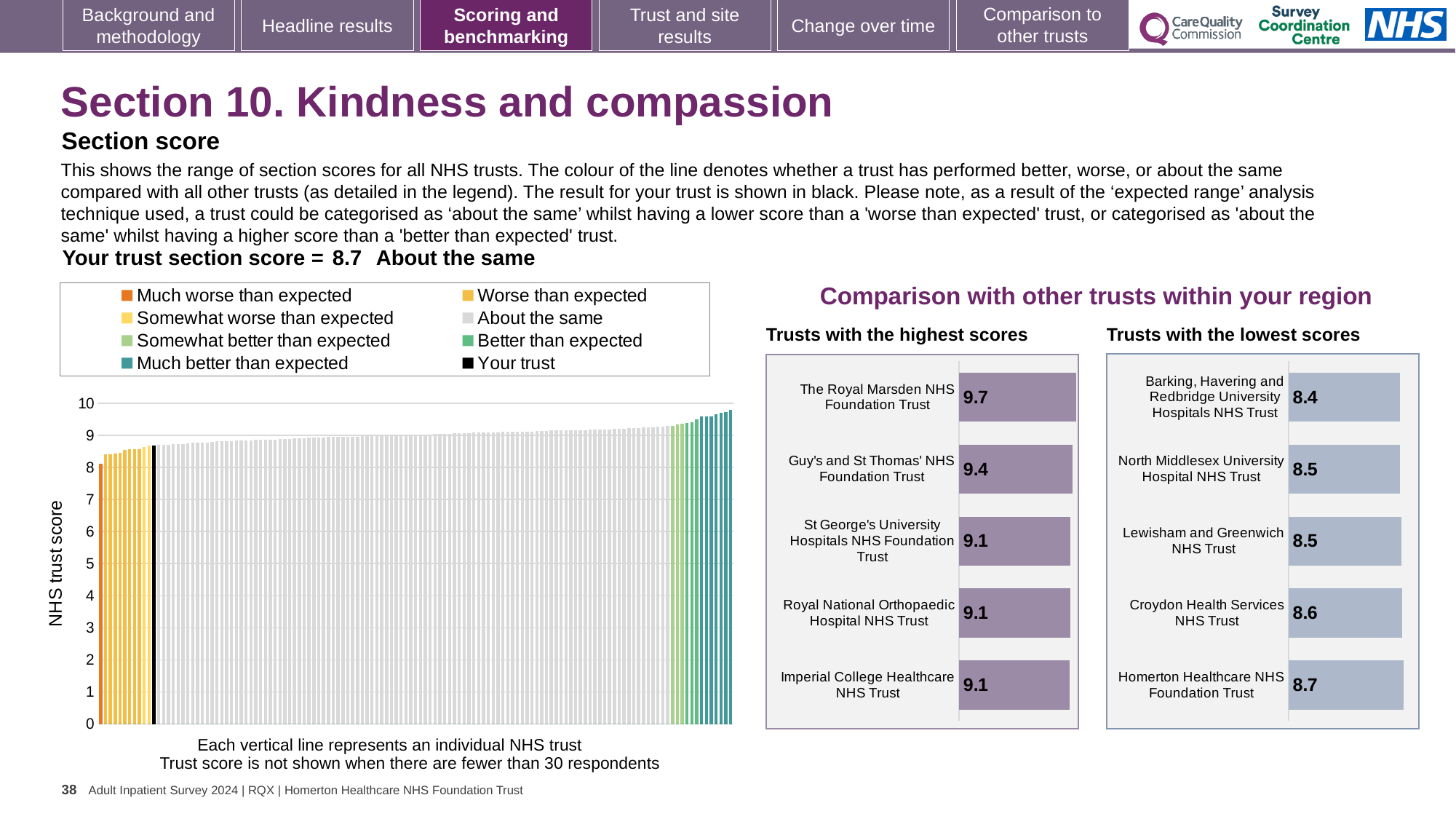
In the NHS trust score chart on the left, do the values rise or fall from left to right? Rise In the 'Trusts with the highest scores' chart, which trust has the highest score? The Royal Marsden NHS Foundation Trust In the 'Trusts with the lowest scores' chart, which trust has the lowest score? Barking, Havering and Redbridge University Hospitals NHS Trust In the 'Trusts with the lowest scores' chart, which has the higher score: Homerton Healthcare NHS Foundation Trust or North Middlesex University Hospital NHS Trust? Homerton Healthcare NHS Foundation Trust In the 'Trusts with the highest scores' chart, what is the difference between the scores of The Royal Marsden NHS Foundation Trust and Guy's and St Thomas' NHS Foundation Trust? 0.3 How many trusts are shown in the 'Trusts with the lowest scores' chart? 5 What kind of chart is the NHS trust score chart on the left of the slide? Bar chart How many entries does the legend of the NHS trust score chart on the left list? 8 In the 'Trusts with the highest scores' chart, what is the score for Guy's and St Thomas' NHS Foundation Trust? 9.4 In the 'Trusts with the highest scores' chart, what is the score for The Royal Marsden NHS Foundation Trust? 9.7 In the 'Trusts with the lowest scores' chart, what is the score for Croydon Health Services NHS Trust? 8.6 In the 'Trusts with the lowest scores' chart, what is the score for Barking, Havering and Redbridge University Hospitals NHS Trust? 8.4